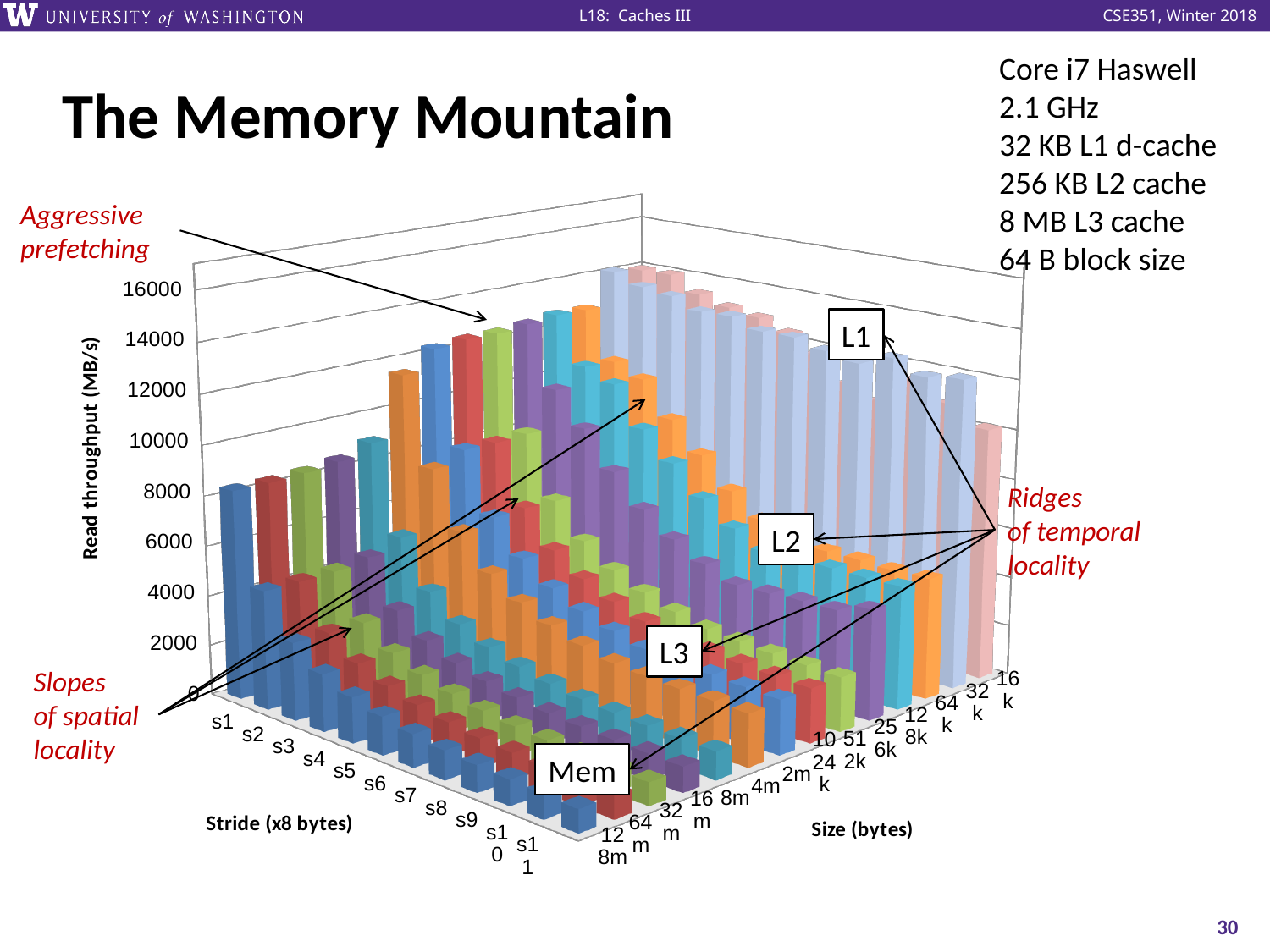
What is the interval between consecutive ticks on the read throughput axis? 2000 What is the label of the vertical axis of the chart? Read throughput (MB/s) Which cache level label is placed at the highest ridge of the chart? L1 What is the label of the axis with categories s1 through s11? Stride (x8 bytes) Does read throughput generally rise or fall as the working-set size increases from 16k toward the largest sizes? fall What kind of chart is shown on the slide? 3D bar chart For a fixed size, does read throughput generally rise or fall as the stride increases from s1 to s11? fall Which labelled region of the chart has the lowest read throughput: L1, L2, L3 or Mem? Mem What is the highest tick value shown on the read throughput axis? 16000 How many stride categories (s1, s2, ...) are plotted on the stride axis? 11